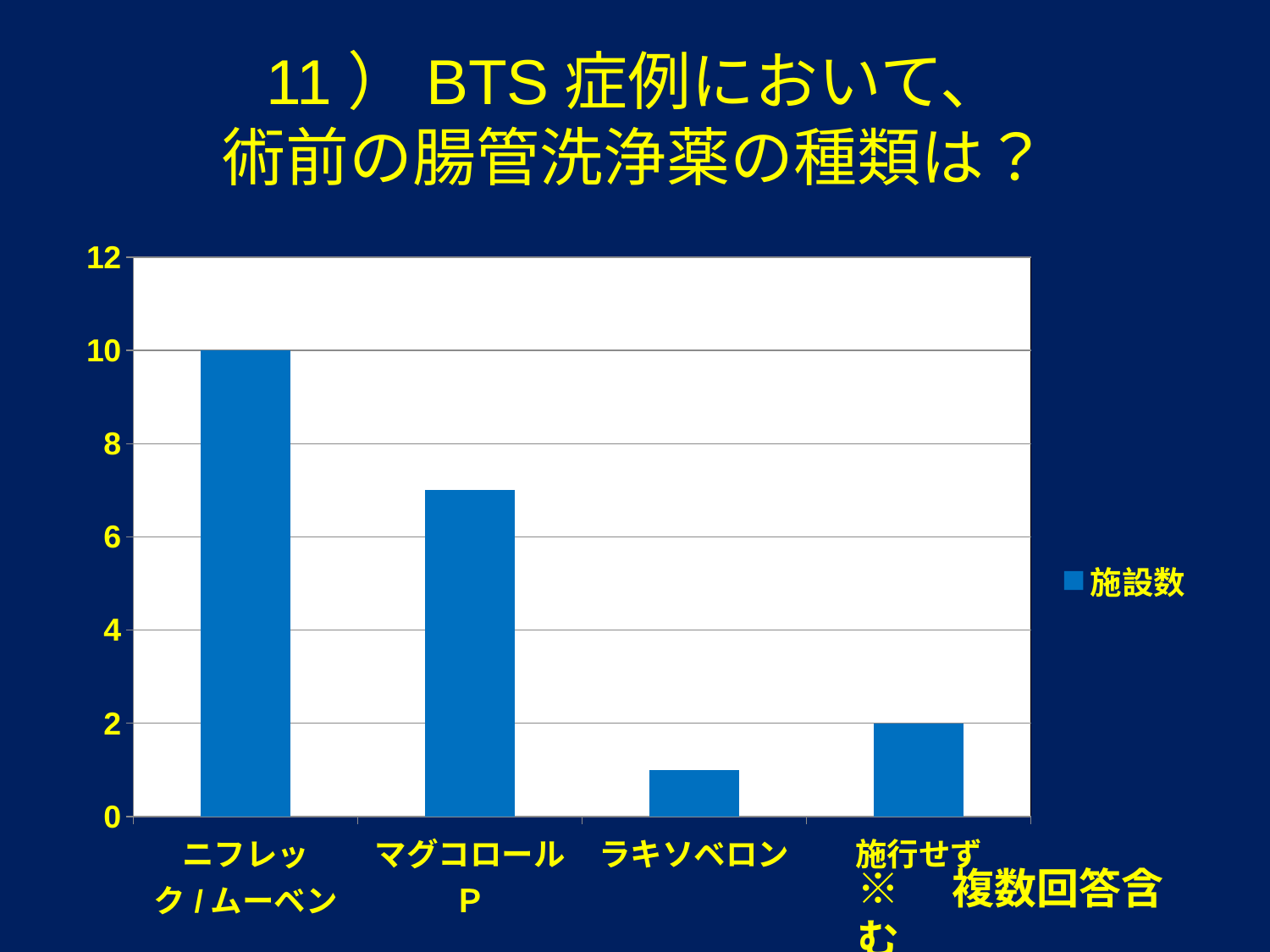
What is the name of the series shown in the legend? 施設数 Which is larger, the value for マグコロールP or the value for 施行せず? マグコロールP What is the value for 施行せず? 2 How many series does the legend list? 1 How many categories are shown on the x axis? 4 What is the difference between the values for ニフレック/ムーベン and 施行せず? 8 Is the value for ラキソベロン greater or less than 2? less What kind of chart is shown on the slide? bar chart Is the value for マグコロールP greater or less than 6? greater Which category has the lowest value? ラキソベロン What is the value for ニフレック/ムーベン? 10 Which category has the highest value? ニフレック/ムーベン